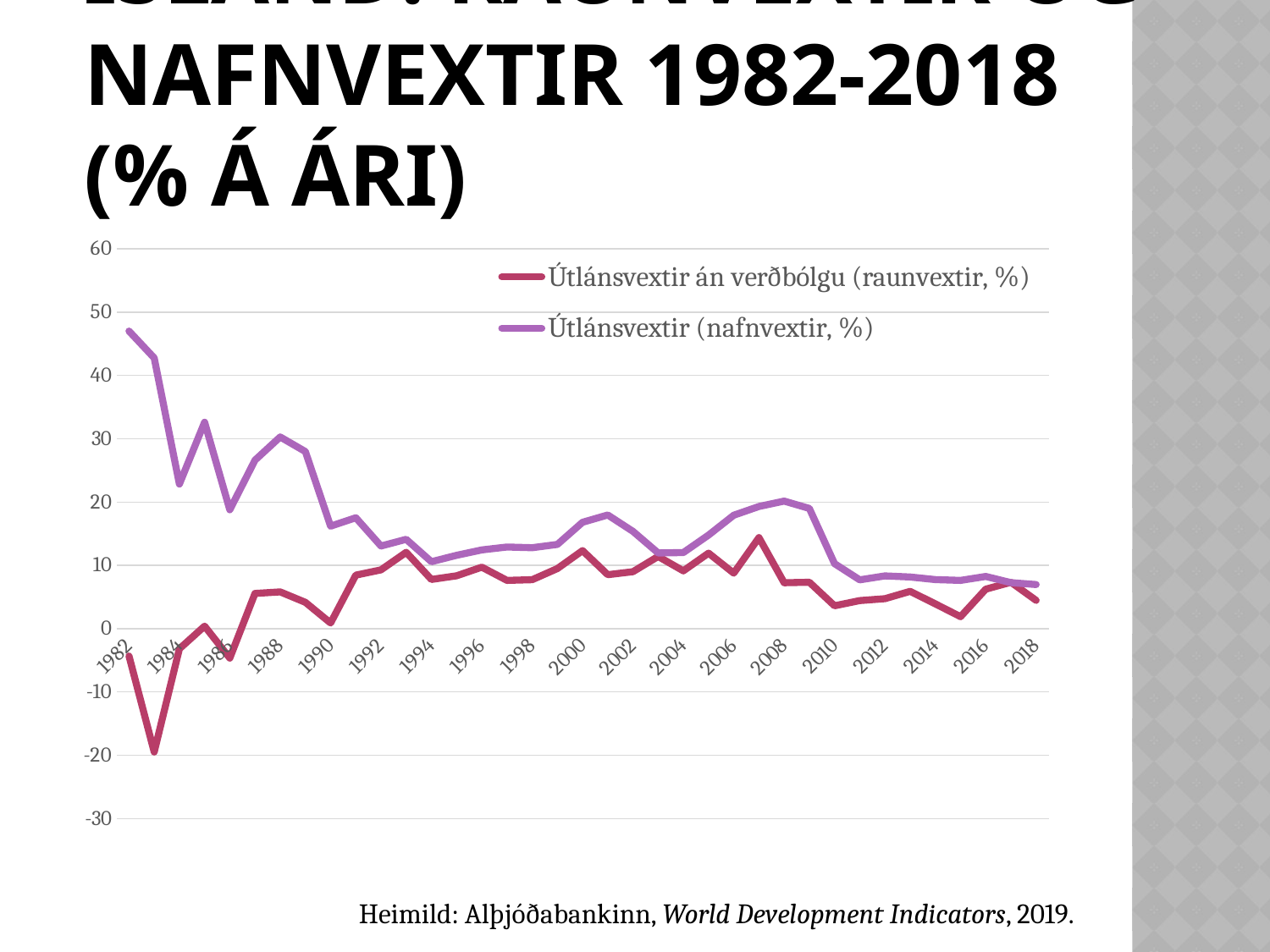
How many series does the legend list? 2 In which year is the Útlánsvextir án verðbólgu (raunvextir, %) series at its lowest? 1983 Is the value for Útlánsvextir (nafnvextir, %) in 1982 greater or less than 40? greater Which series is drawn in purple? Útlánsvextir (nafnvextir, %) Does the Útlánsvextir (nafnvextir, %) series generally rise or fall from 1982 to 1990? fall What source is cited below the chart? Alþjóðabankinn, World Development Indicators, 2019 Is the value for Útlánsvextir án verðbólgu (raunvextir, %) in 1983 greater or less than -10? less What kind of chart is shown on the slide? line chart Is the value for Útlánsvextir (nafnvextir, %) in 2008 greater or less than 15? greater In 1982, which series has the larger value: Útlánsvextir (nafnvextir, %) or Útlánsvextir án verðbólgu (raunvextir, %)? Útlánsvextir (nafnvextir, %) In which year is the Útlánsvextir (nafnvextir, %) series at its highest? 1982